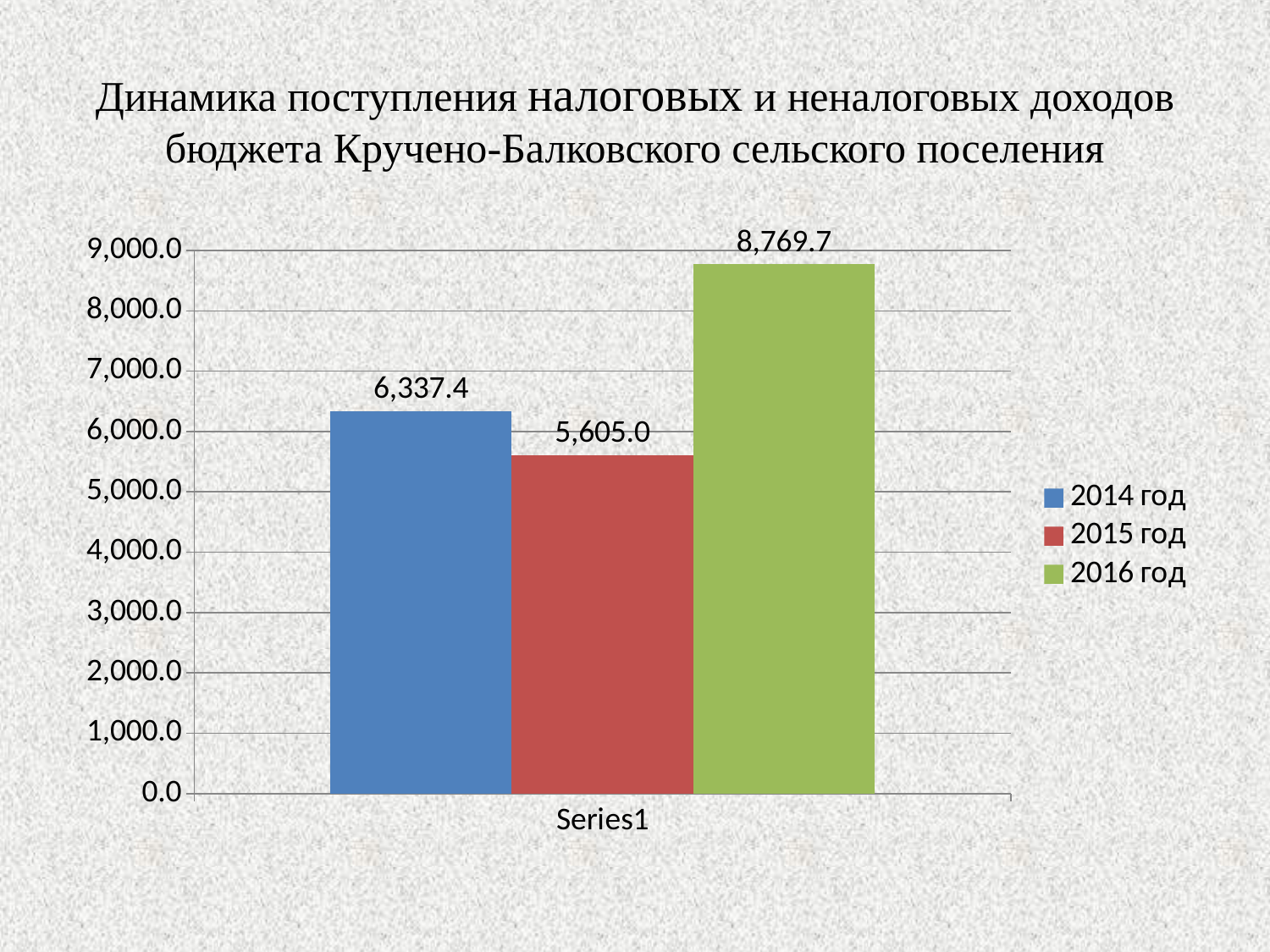
What kind of chart is shown on the slide? bar chart What is the difference between the values for 2014 год and 2015 год? 732.4 What colour is the bar for 2016 год? green What is the difference between the values for 2016 год and 2015 год? 3,164.7 Which year has the lowest value? 2015 год How many series does the legend list? 3 What is the value for 2014 год? 6,337.4 Which is larger, the value for 2014 год or the value for 2015 год? 2014 год Is the value for 2016 год greater or less than 8,000.0? greater What is the value for 2016 год? 8,769.7 What is the value for 2015 год? 5,605.0 Which year has the highest value? 2016 год